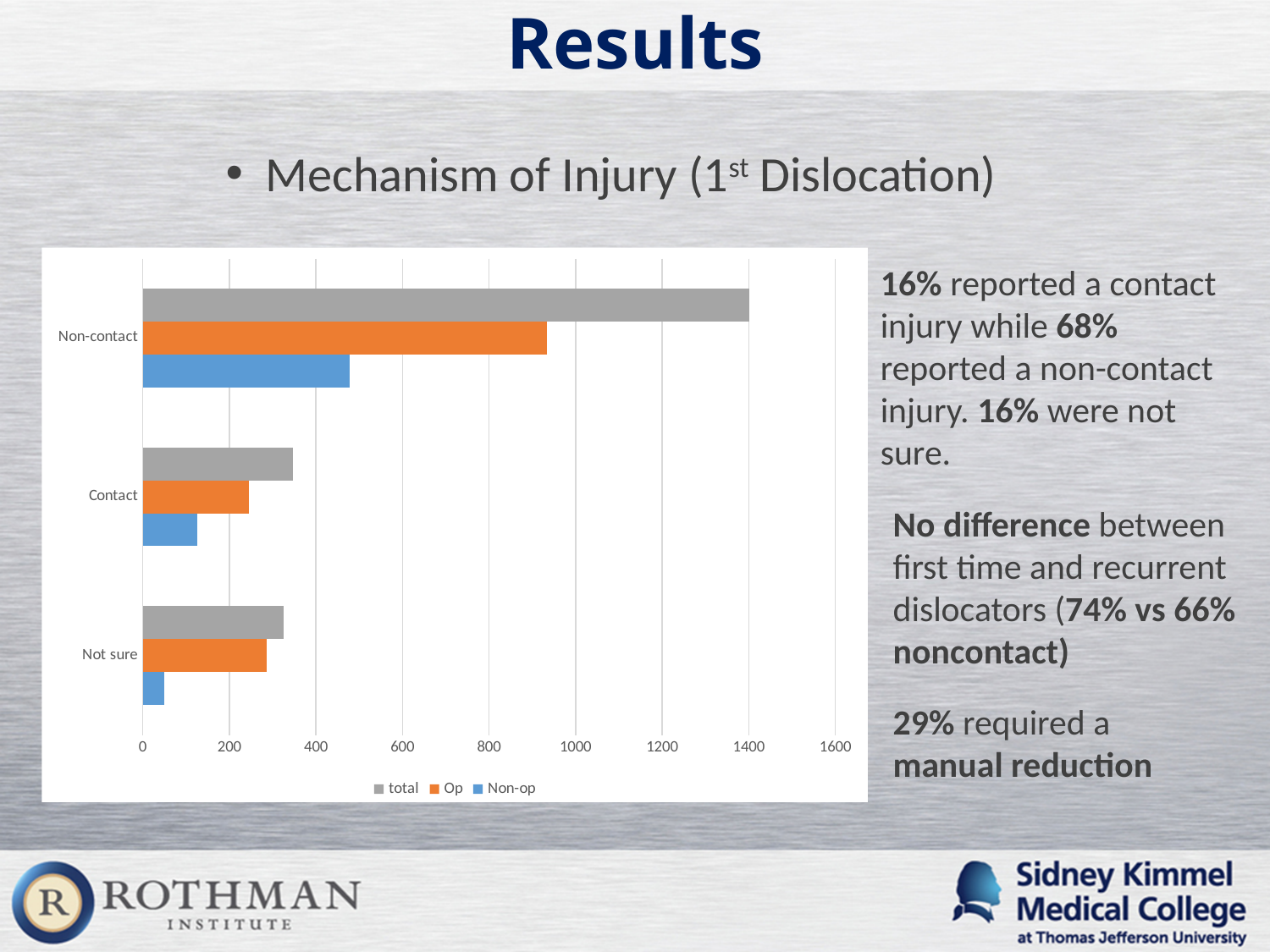
How many categories are shown on the chart? 3 Is the Non-op value for Not sure greater or less than 200? less Which category has the highest value for the total series? Non-contact Is the total value for Contact greater or less than 400? less For the Non-contact category, which is larger: the Op value or the Non-op value? Op What are the three series listed in the chart legend? total, Op, Non-op Is the Op value for Non-contact greater or less than 800? greater What kind of chart is shown on the slide? bar chart Which is larger: the Non-op value for Contact or the Non-op value for Not sure? Contact How many series does the chart legend list? 3 Which category has the lowest value for the Non-op series? Not sure